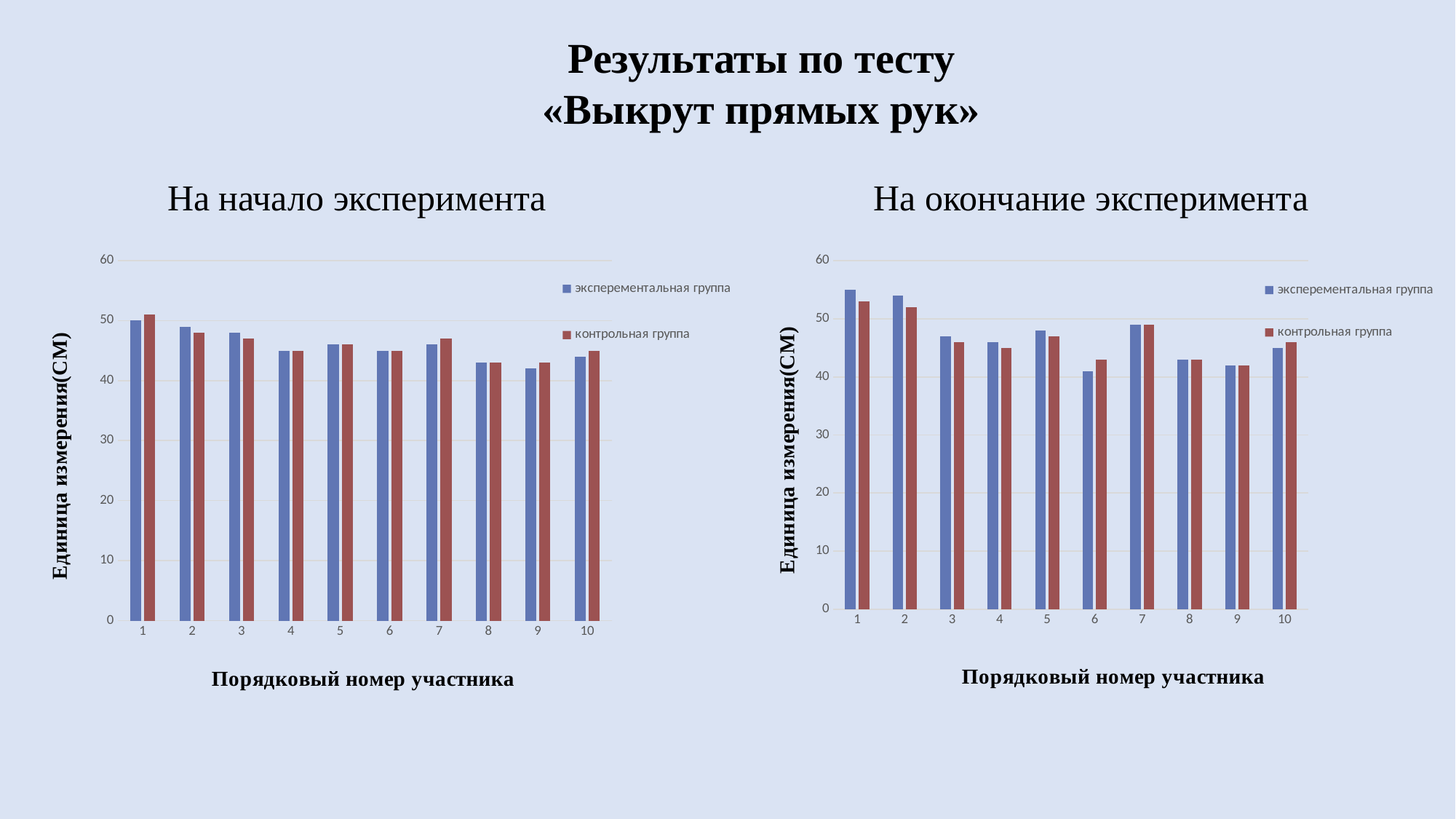
In the chart titled «На окончание эксперимента», for participant 6, which series has the larger value: экспереметальная группа or контрольная группа? контрольная группа How many series does the legend of the chart titled «На начало эксперимента» list? 2 In the chart titled «На окончание эксперимента», is the value for экспереметальная группа for participant 1 greater or less than 50? greater In the chart titled «На начало эксперимента», is the value for экспереметальная группа for participant 9 greater or less than 40? greater In the chart titled «На окончание эксперимента», for participant 1, which series has the larger value: экспереметальная группа or контрольная группа? экспереметальная группа In the chart titled «На окончание эксперимента», how many participants are shown on the x axis? 10 In the chart titled «На окончание эксперимента», is the value for контрольная группа for participant 2 greater or less than 50? greater In the chart titled «На начало эксперимента», which participant has the highest value for контрольная группа? 1 What is the y-axis label of the chart titled «На окончание эксперимента»? Единица измерения(СМ) In the chart titled «На начало эксперимента», what colour are the bars for контрольная группа? red What kind of chart is the chart titled «На начало эксперимента»? bar chart